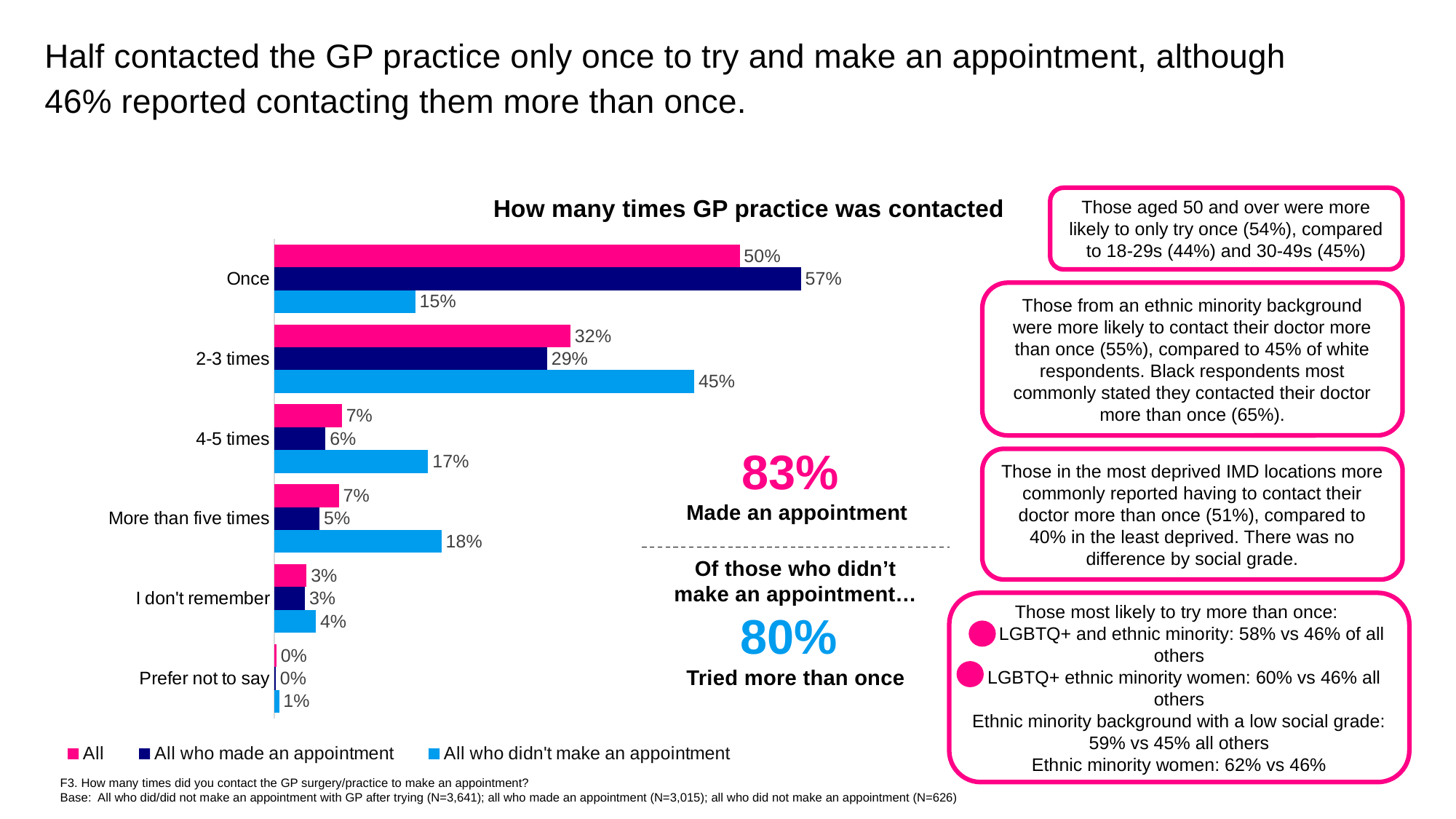
What is the value for 'Once' in the 'All' series? 50% Which category has the highest value in the 'All who didn't make an appointment' series? 2-3 times What is the difference between the 'All who made an appointment' and 'All who didn't make an appointment' values for 'Once'? 42 percentage points How many categories are shown on the chart? 6 Which category has the highest value in the 'All who made an appointment' series? Once What is the value for 'More than five times' in the 'All who made an appointment' series? 5% What is the value for '2-3 times' in the 'All who didn't make an appointment' series? 45% For '4-5 times', which series has the larger value: 'All' or 'All who didn't make an appointment'? All who didn't make an appointment What is the title of the chart? How many times GP practice was contacted What kind of chart is shown on the slide? Bar chart How many series does the legend list? 3 Which colour represents the 'All who made an appointment' series? Dark blue (navy)